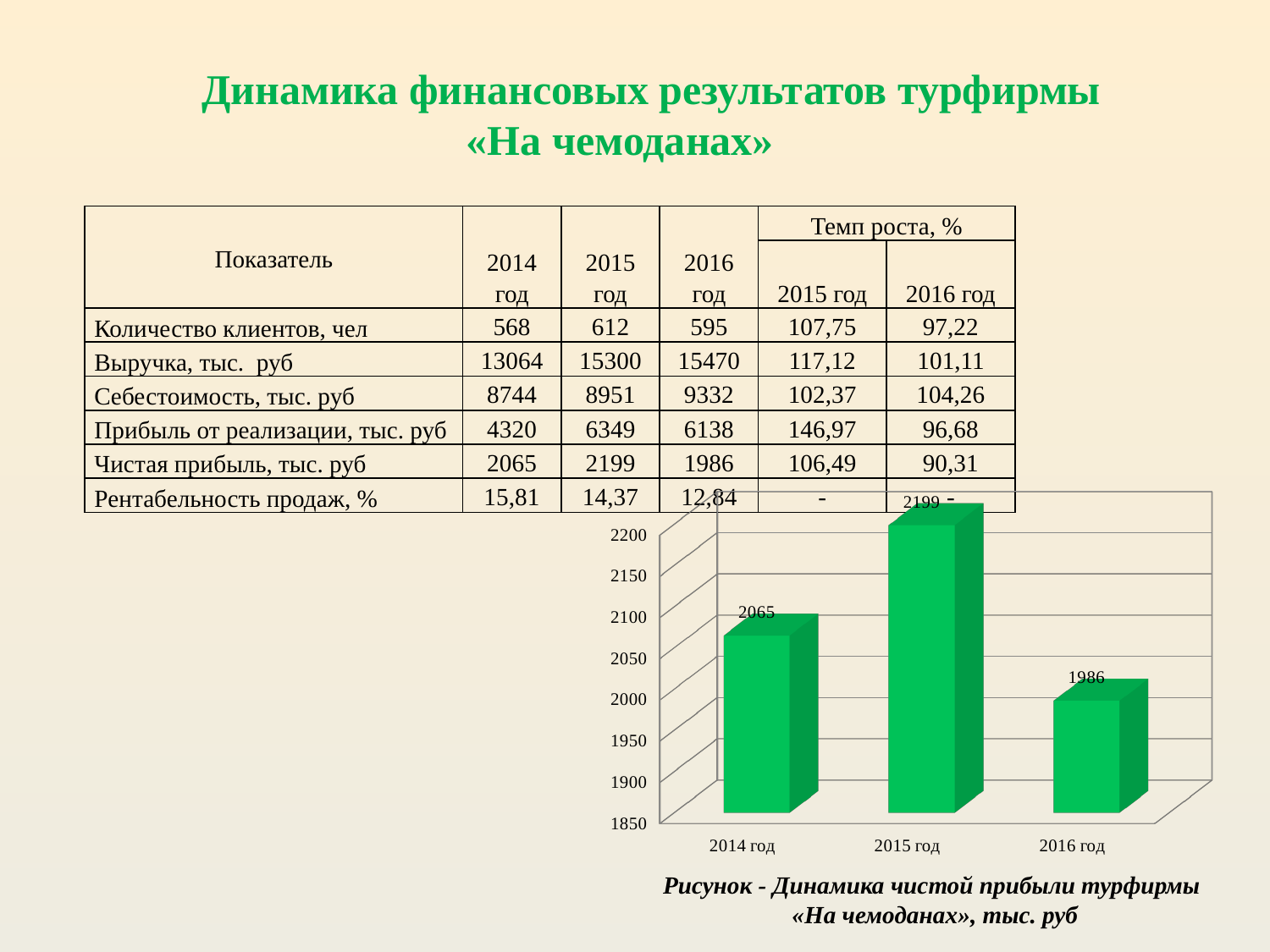
What is the difference between the values for 2014 год and 2016 год in the chart? 79 How many bars are shown in the chart? 3 What is the value for 2014 год in the chart? 2065 Which is larger in the chart, the value for 2014 год or the value for 2016 год? 2014 год What is the value for 2015 год in the chart? 2199 What is the value for 2016 год in the chart? 1986 Which year has the lowest value in the chart? 2016 год What is the difference between the values for 2015 год and 2014 год in the chart? 134 Is the value for 2016 год in the chart greater or less than 2000? less Which year has the highest value in the chart? 2015 год What is the caption of the chart on the slide? Рисунок - Динамика чистой прибыли турфирмы «На чемоданах», тыс. руб What kind of chart is shown on the slide? bar chart